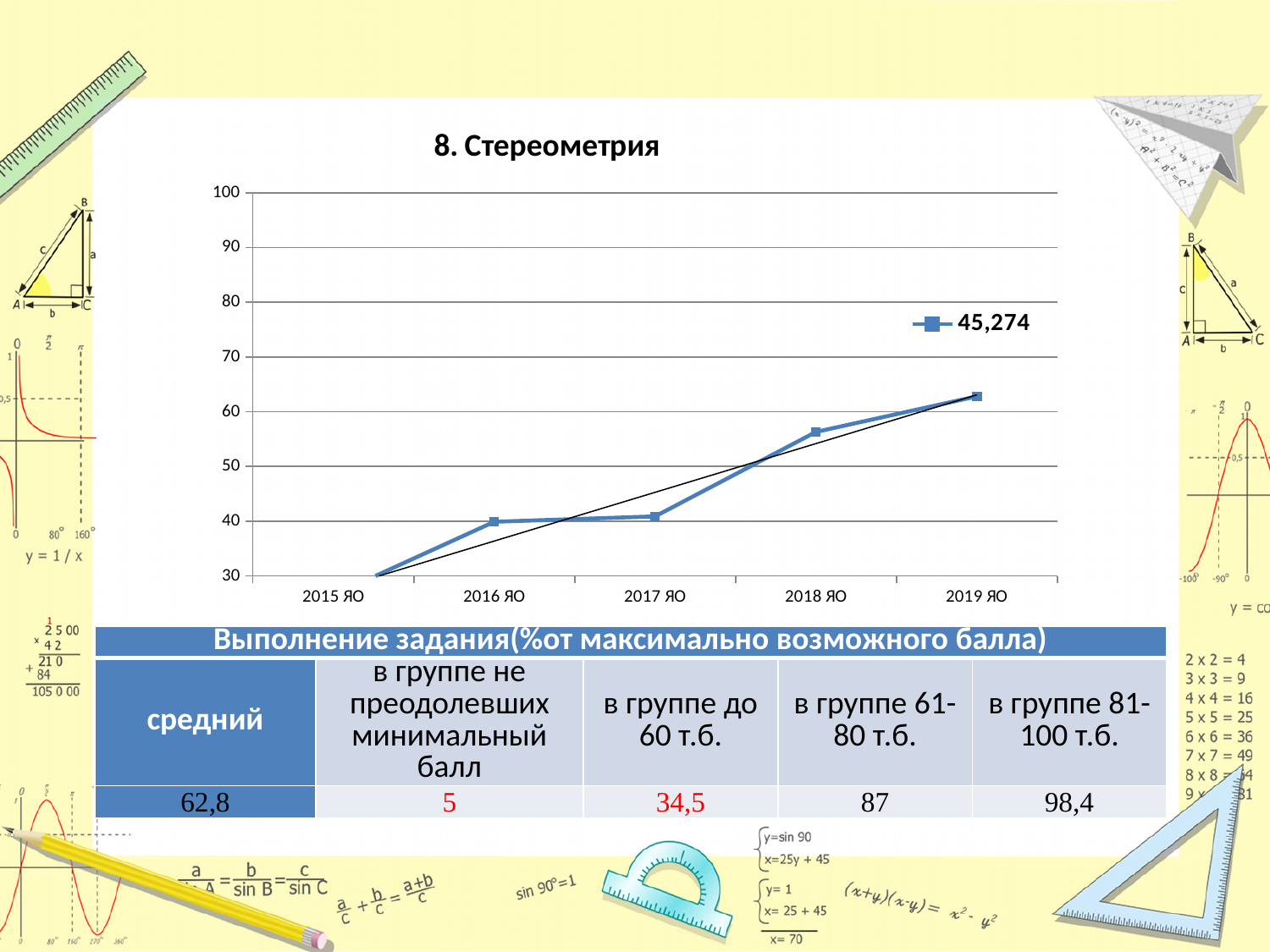
How many data points are plotted along the x axis of the chart? 5 Is the value for 2017 ЯО greater or less than 50? less Which year has the highest value on the chart? 2019 ЯО Which year has the lowest value on the chart? 2015 ЯО What is the title of the chart? 8. Стереометрия How many series does the chart legend list? 1 Do the values rise or fall from 2015 ЯО to 2019 ЯО? rise Which is larger, the value for 2016 ЯО or the value for 2018 ЯО? 2018 ЯО Is the value for 2018 ЯО greater or less than 50? greater What is the legend entry shown for the plotted series? 45,274 What kind of chart is shown on the slide? line chart Is the value for 2019 ЯО greater or less than 60? greater